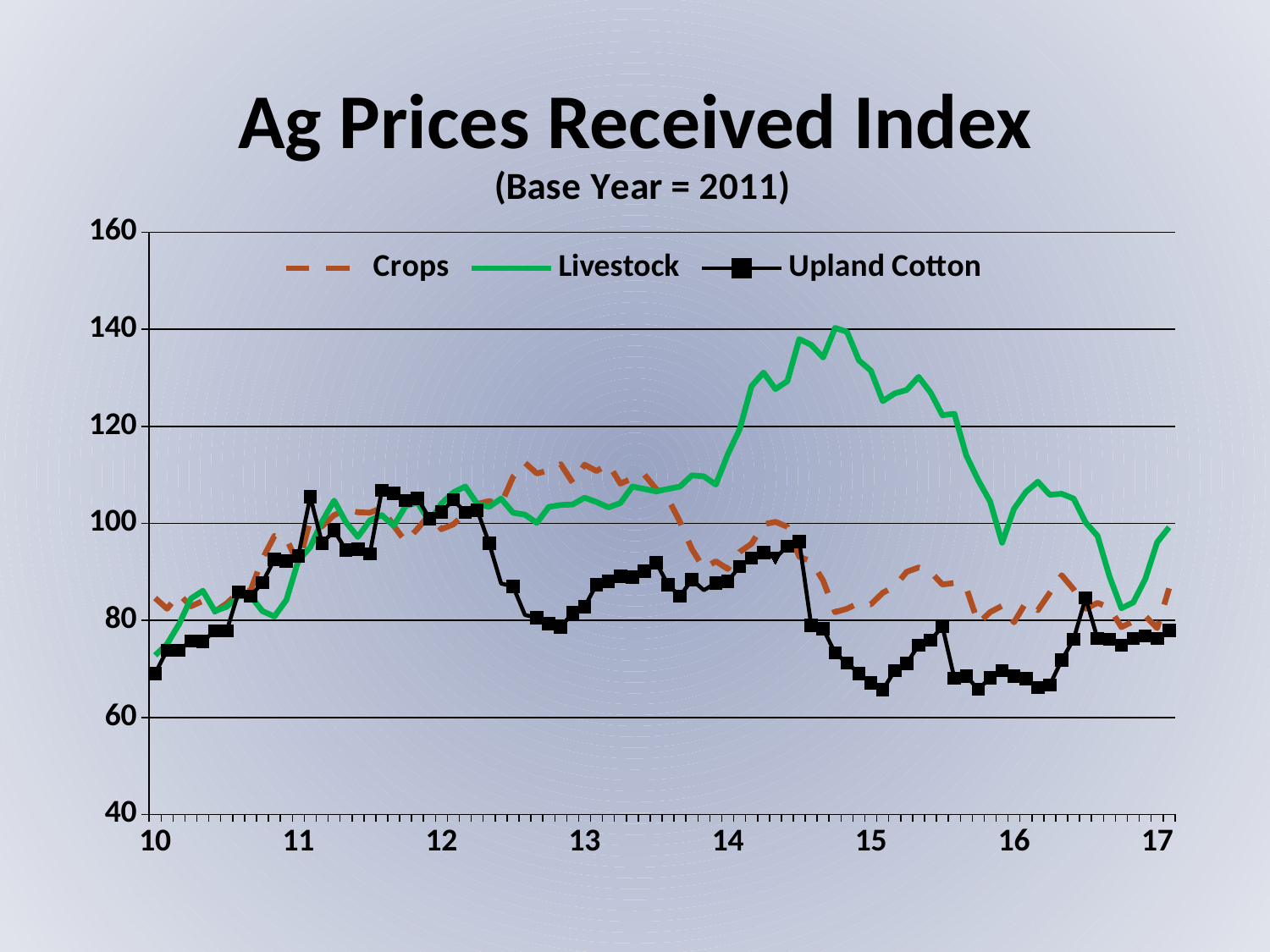
What is the title of the chart? Ag Prices Received Index Does the Livestock series rise or fall between the start of 2015 and the start of 2016? fall What kind of chart is shown on the slide? Line chart Is the value for Crops at the start of 2013 greater or less than 100? greater Which series reaches the highest value on the chart? Livestock Is the value for Upland Cotton at the start of 2010 greater or less than 80? less What base year does the chart subtitle state for the index? 2011 Which series reaches the lowest value on the chart? Upland Cotton Is the peak value of the Livestock series greater or less than 120? greater At the start of 2015, which is larger, Livestock or Upland Cotton? Livestock At the start of 2013, which is larger, Crops or Upland Cotton? Crops How many series does the legend list? 3